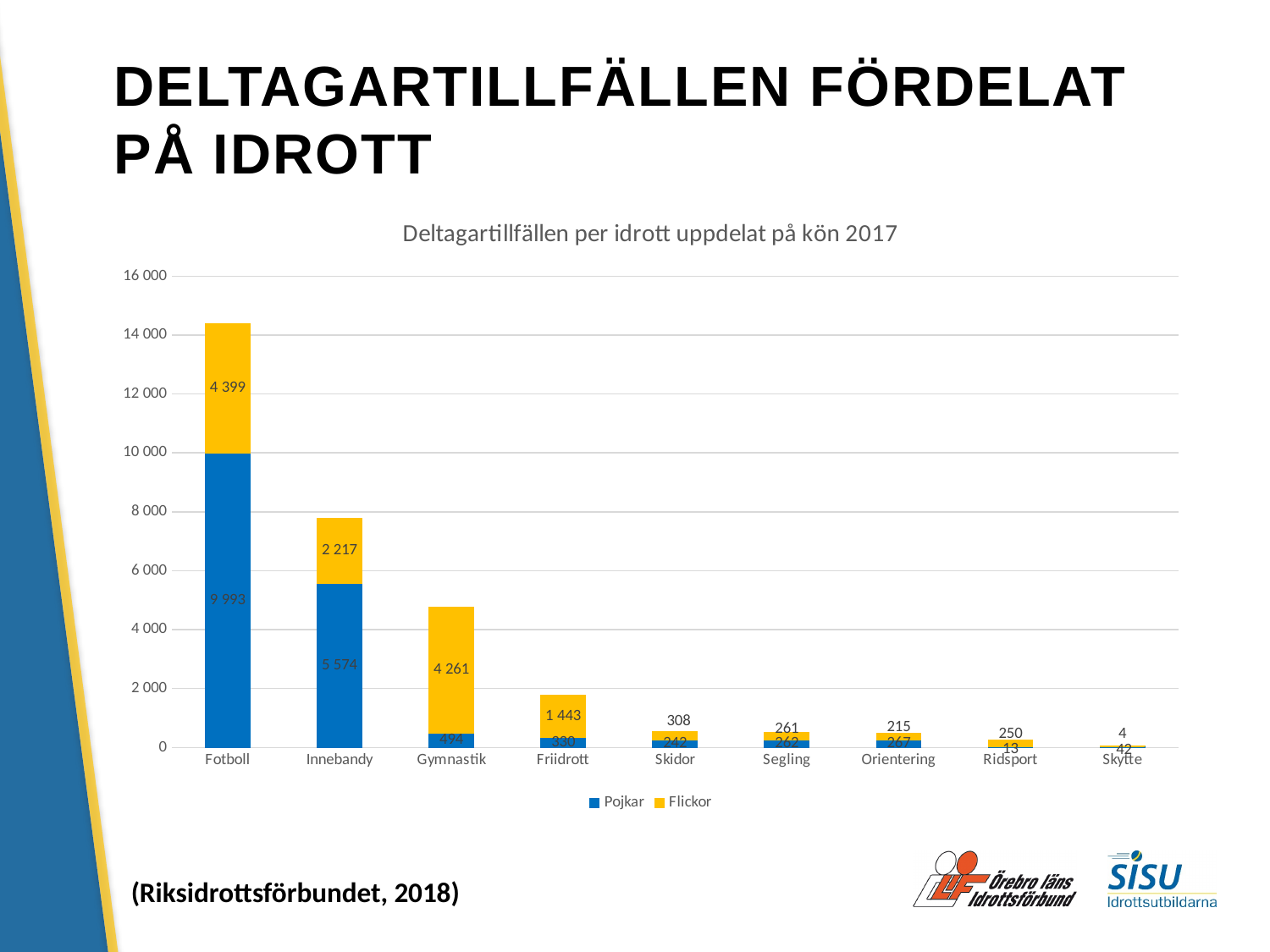
What is the Pojkar value for Fotboll? 9 993 How many sports (categories) are shown on the x axis? 9 What is the total of the stacked bar for Innebandy? 7 791 How many series does the legend list? 2 Which sport has the lowest total number of deltagartillfällen? Skytte What is the difference between the Pojkar and Flickor values for Fotboll? 5 594 What is the Flickor value for Gymnastik? 4 261 Is the total value for Gymnastik greater or less than 4 000? greater What type of chart is shown on the slide? Stacked bar chart For Gymnastik, which is larger: the Pojkar value or the Flickor value? Flickor What is the Flickor value for Friidrott? 1 443 Which sport has the highest total number of deltagartillfällen? Fotboll